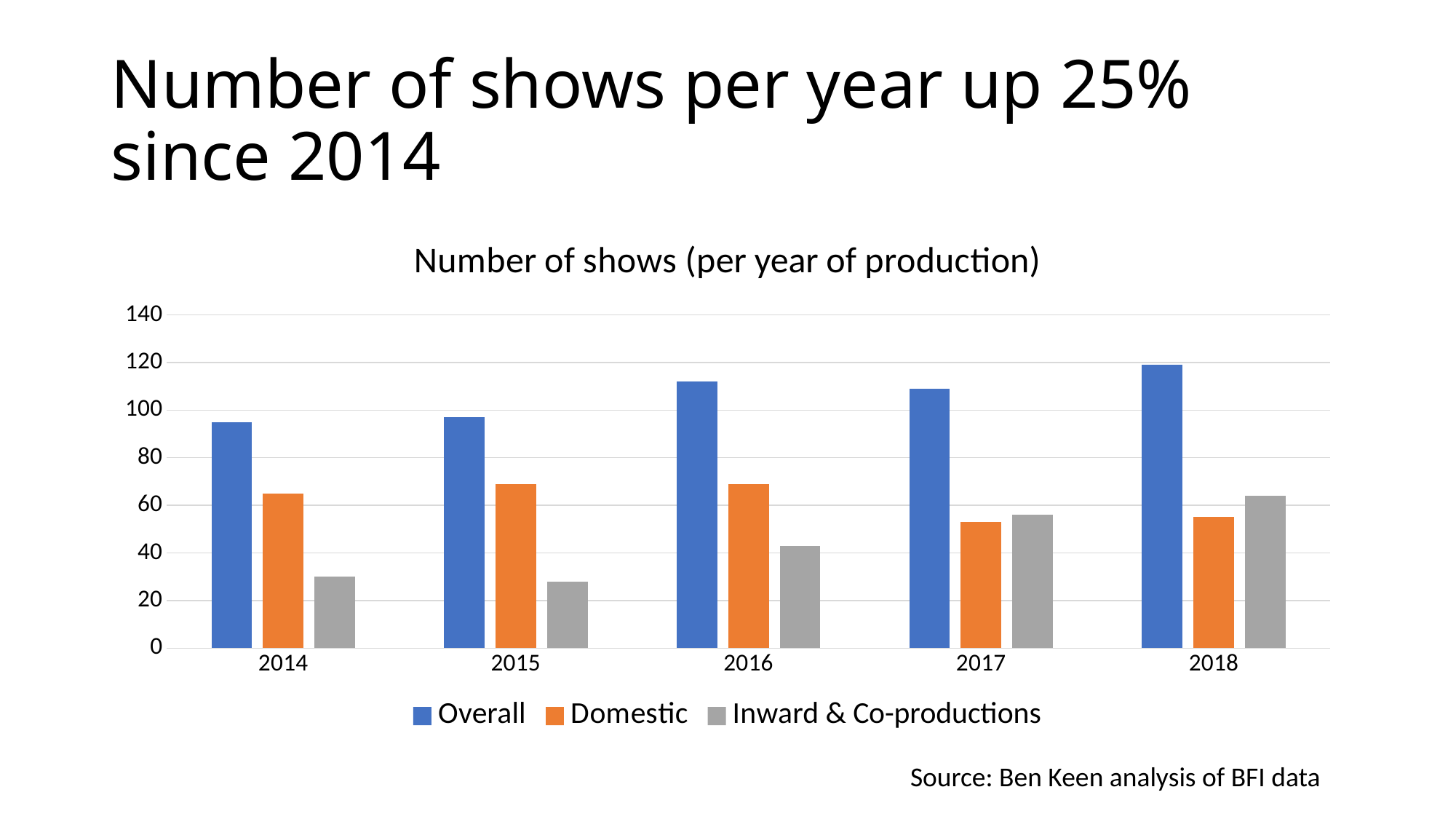
What kind of chart is shown on the slide? bar chart In 2018, which is larger: Domestic or Inward & Co-productions? Inward & Co-productions How many series does the legend list? 3 Does the Inward & Co-productions value rise or fall from 2016 to 2018? rise Is the value for Overall in 2014 greater or less than 100? less Is the value for Domestic in 2014 greater or less than 60? greater In which year is the Inward & Co-productions value highest? 2018 Is the value for Overall in 2016 greater or less than 100? greater In which year is the Overall value highest? 2018 What is the title of the chart? Number of shows (per year of production) How many years are shown on the x axis? 5